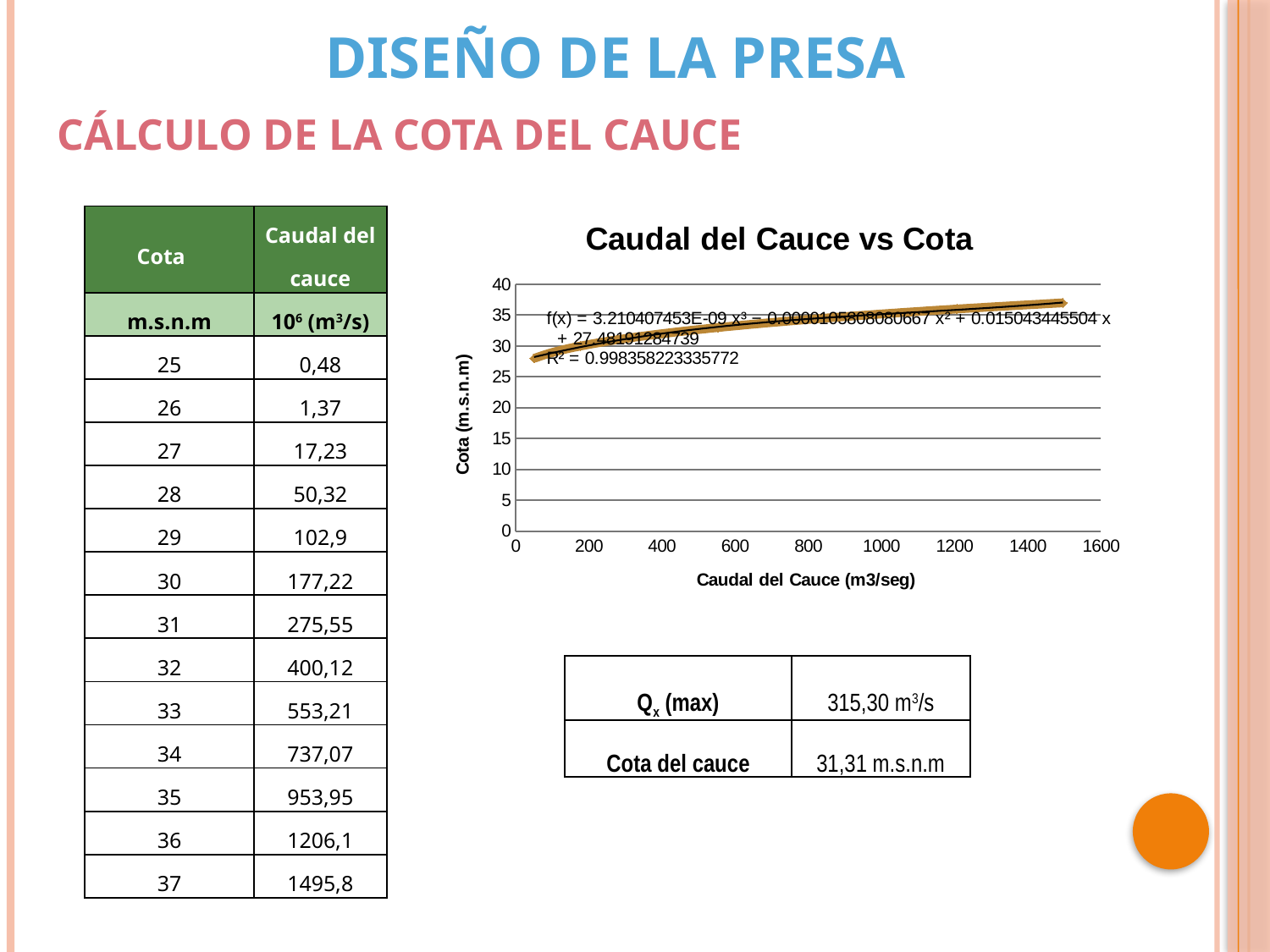
Is the Cota value at a Caudal del Cauce of 1400 greater or less than 30? greater What is the highest tick value shown on the x axis of the chart? 1600 What is the title of the x axis of the chart? Caudal del Cauce (m3/seg) What is the title of the chart? Caudal del Cauce vs Cota What R² value is printed on the chart for the trendline? 0.998358223335772 Is the Cota value at a Caudal del Cauce of 800 greater or less than 25? greater What is the highest tick value shown on the y axis of the chart? 40 Does the Cota value rise or fall as Caudal del Cauce increases along the x axis? rise What kind of chart is shown on the slide? line chart